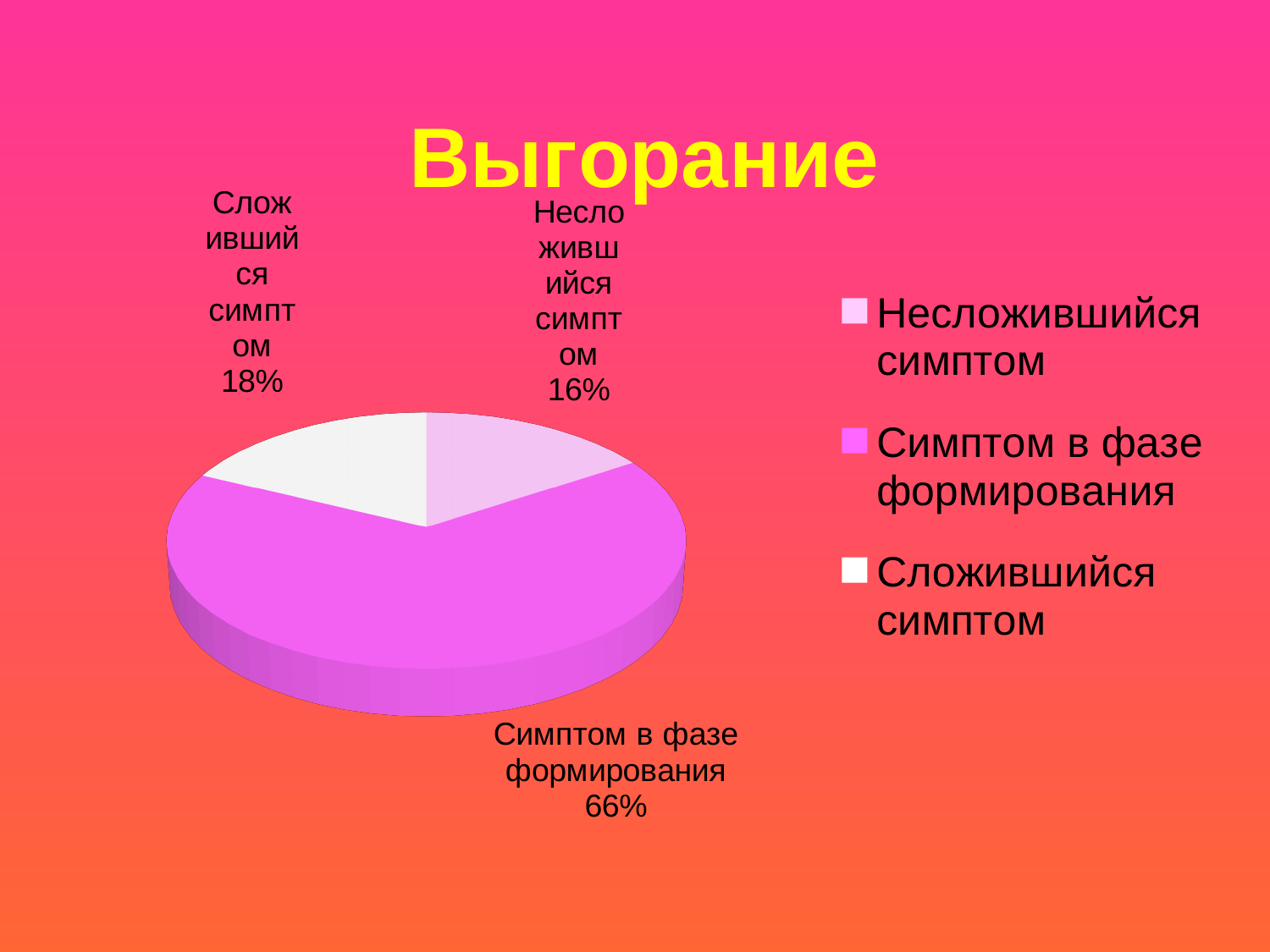
What share of the pie does 'Симптом в фазе формирования' have? 66% What share of the pie does 'Несложившийся симптом' have? 16% What is the title of the slide with the pie chart? Выгорание Which category has the largest slice of the pie? Симптом в фазе формирования What is the difference in percentage points between 'Сложившийся симптом' and 'Несложившийся симптом'? 2 What is the difference in percentage points between 'Симптом в фазе формирования' and 'Сложившийся симптом'? 48 Which category has the smallest slice of the pie? Несложившийся симптом What share of the pie does 'Сложившийся симптом' have? 18% Which is larger: the share for 'Сложившийся симптом' or for 'Несложившийся симптом'? Сложившийся симптом What colour is the slice for 'Сложившийся симптом'? white How many categories are shown in the pie chart? 3 What kind of chart is shown on the slide? pie chart